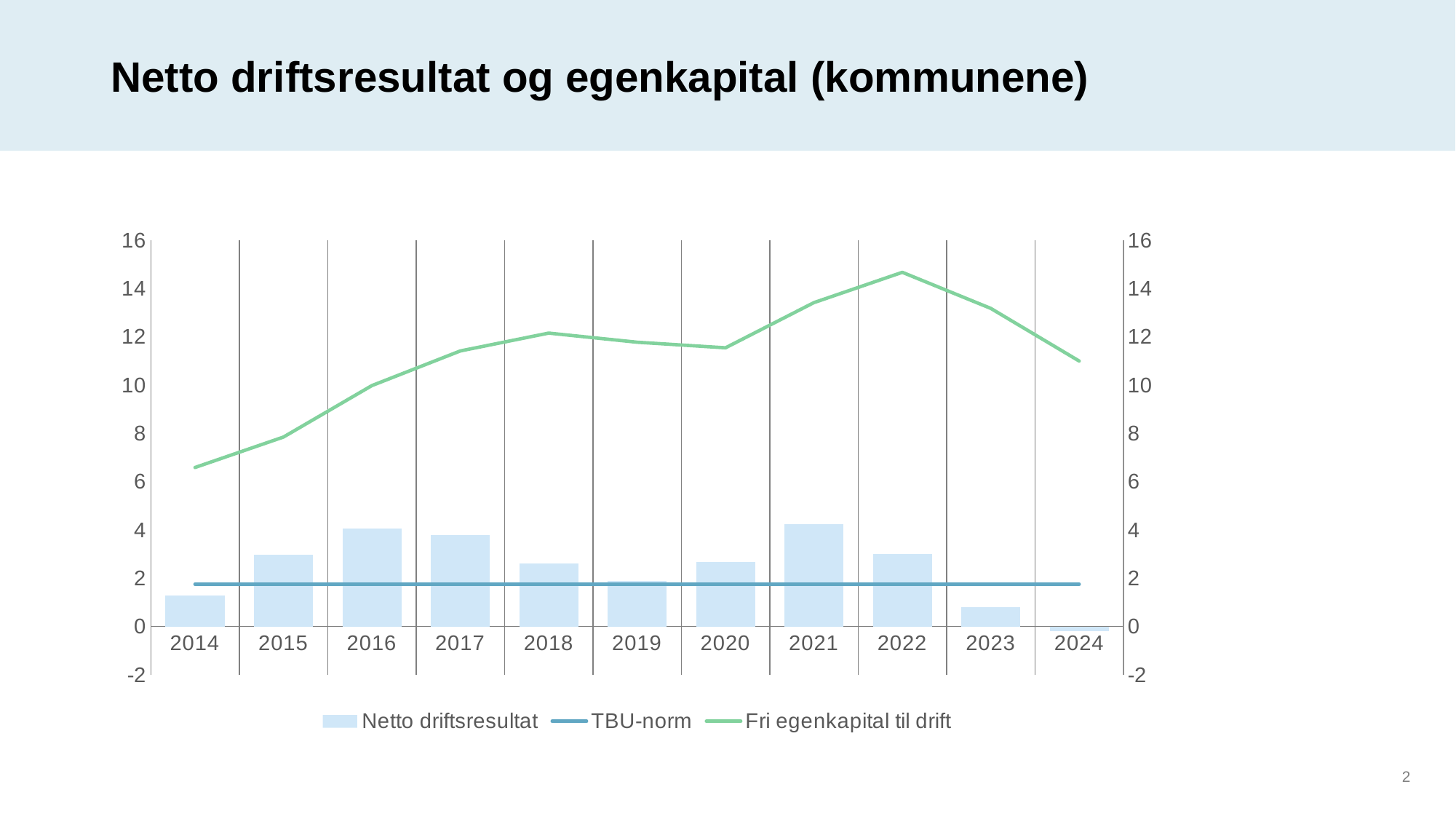
Is the value of Netto driftsresultat in 2023 greater or less than 2? less How many years are shown on the x axis? 11 In which year is Netto driftsresultat lowest? 2024 Is the value of Fri egenkapital til drift in 2022 greater or less than 14? greater How many series does the legend list? 3 What kind of chart is shown on the slide? A combined bar and line chart In which year is Fri egenkapital til drift lowest? 2014 Which series is drawn as a green line? Fri egenkapital til drift In which year is Fri egenkapital til drift highest? 2022 Which is larger, Netto driftsresultat in 2016 or in 2015? 2016 Does Fri egenkapital til drift rise or fall from 2014 to 2018? Rise Is the value of Netto driftsresultat in 2021 greater or less than 4? greater